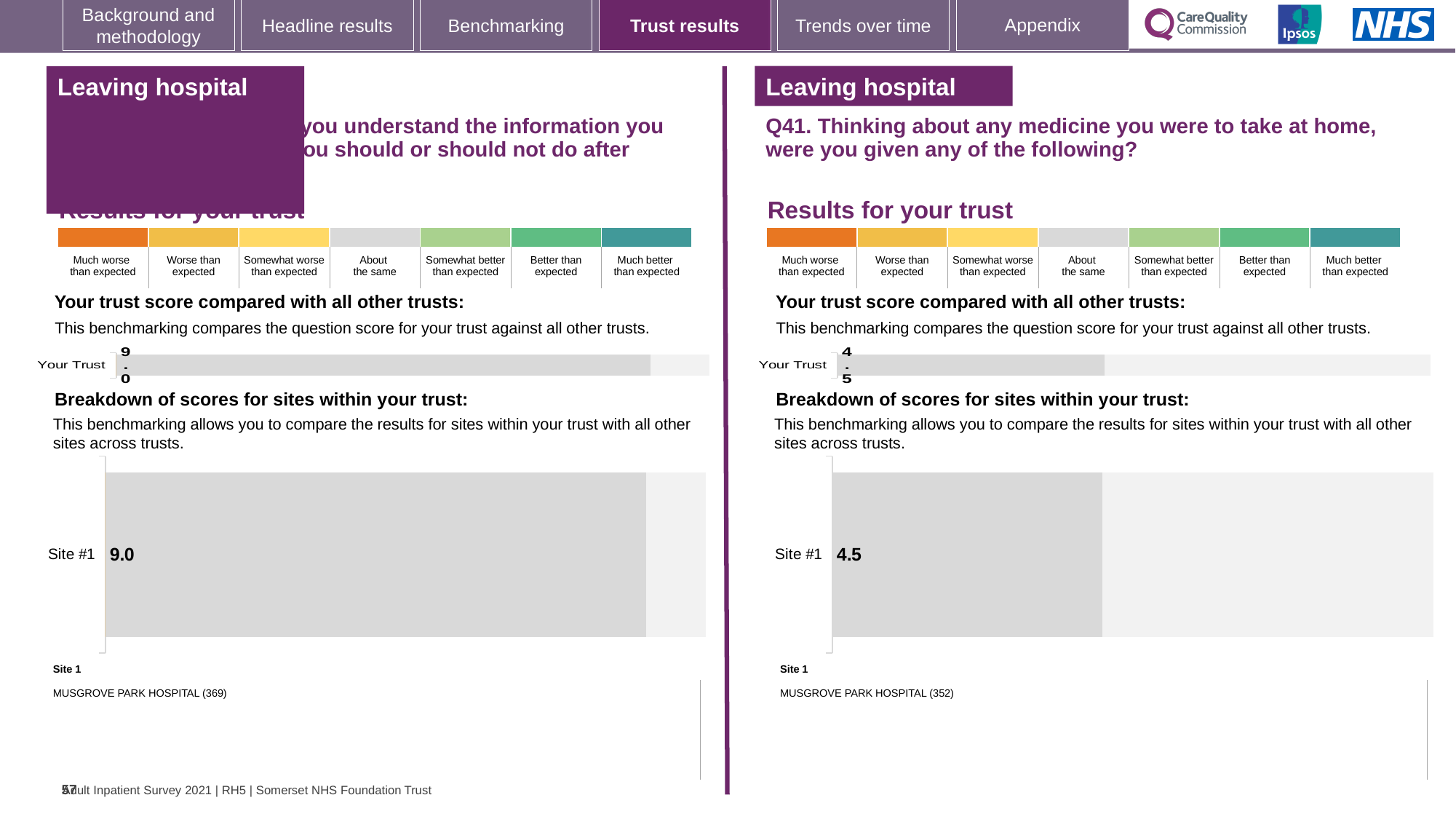
On the left-hand panel, what is the score shown for Site #1? 9.0 On the right-hand panel (Q41), how many sites are shown in the breakdown of scores chart? 1 Which is larger: the Site #1 score on the left-hand panel or the Site #1 score on the right-hand panel (Q41)? Left-hand panel On the right-hand panel (Q41), what is the score shown for Your Trust? 4.5 On the left-hand panel, what is the score shown for Your Trust? 9.0 On the left-hand panel, how many sites are shown in the breakdown of scores chart? 1 What type of chart is used to show the Site #1 score on the right-hand panel (Q41)? Bar chart On the left-hand panel, which site name is listed under Site 1? MUSGROVE PARK HOSPITAL (369) On the right-hand panel (Q41), is the Site #1 score greater or less than the Your Trust score? Equal What is the difference between the Site #1 score on the left-hand panel and the Site #1 score on the right-hand panel (Q41)? 4.5 On the right-hand panel (Q41), which site name is listed under Site 1? MUSGROVE PARK HOSPITAL (352) On the right-hand panel (Q41), what is the score shown for Site #1? 4.5